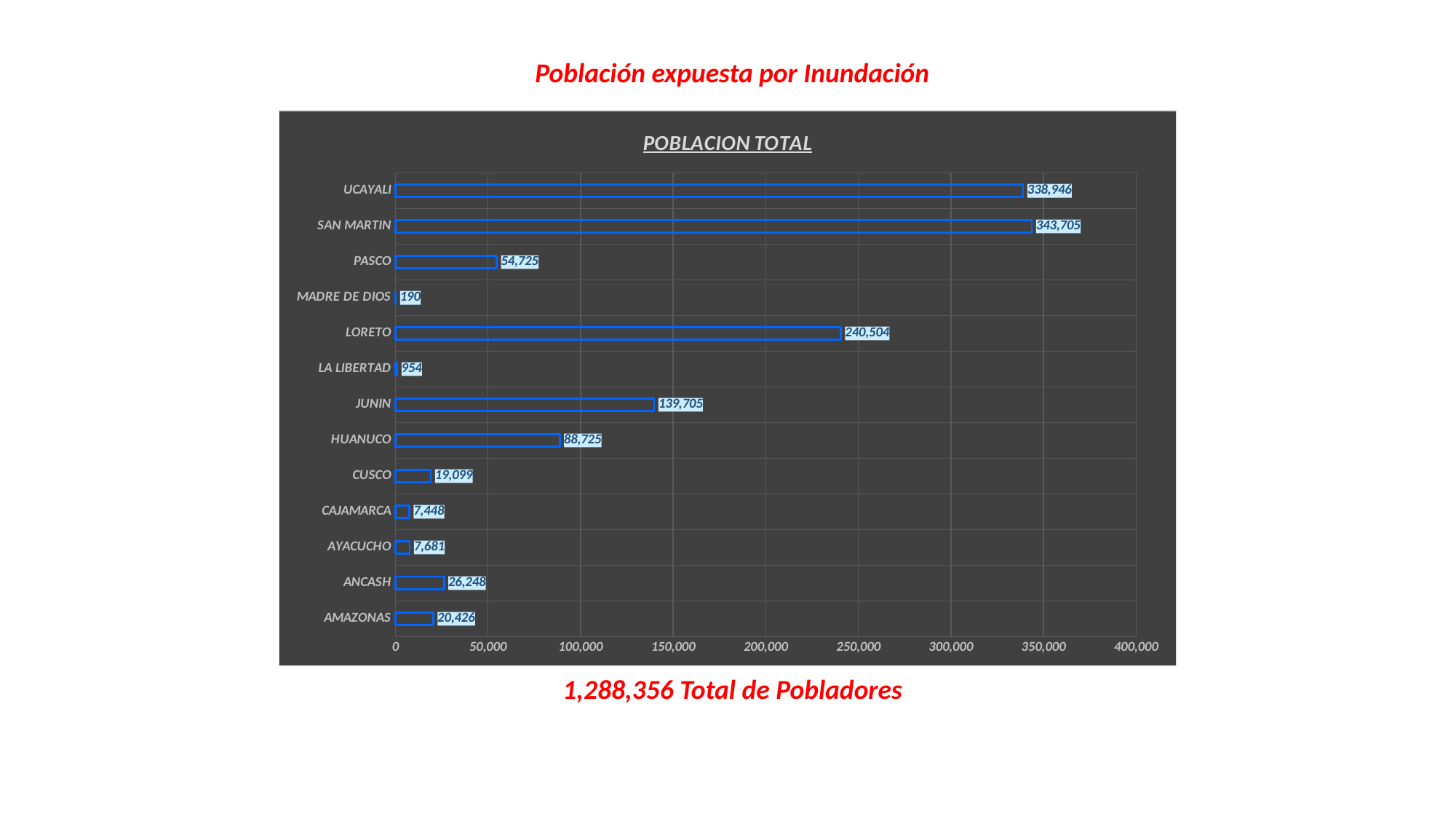
Which category has the highest value? SAN MARTIN How many categories are shown in the chart? 13 What is the value for HUANUCO? 88,725 What kind of chart is shown on the slide? bar chart What is the value for LORETO? 240,504 What is the difference between the values for SAN MARTIN and UCAYALI? 4,759 Which is larger, the value for ANCASH or the value for AMAZONAS? ANCASH Is the value for JUNIN greater or less than 100,000? greater Which category has the lowest value? MADRE DE DIOS What is the difference between the values for LORETO and JUNIN? 100,799 What is the title of the chart? POBLACION TOTAL What is the value for MADRE DE DIOS? 190